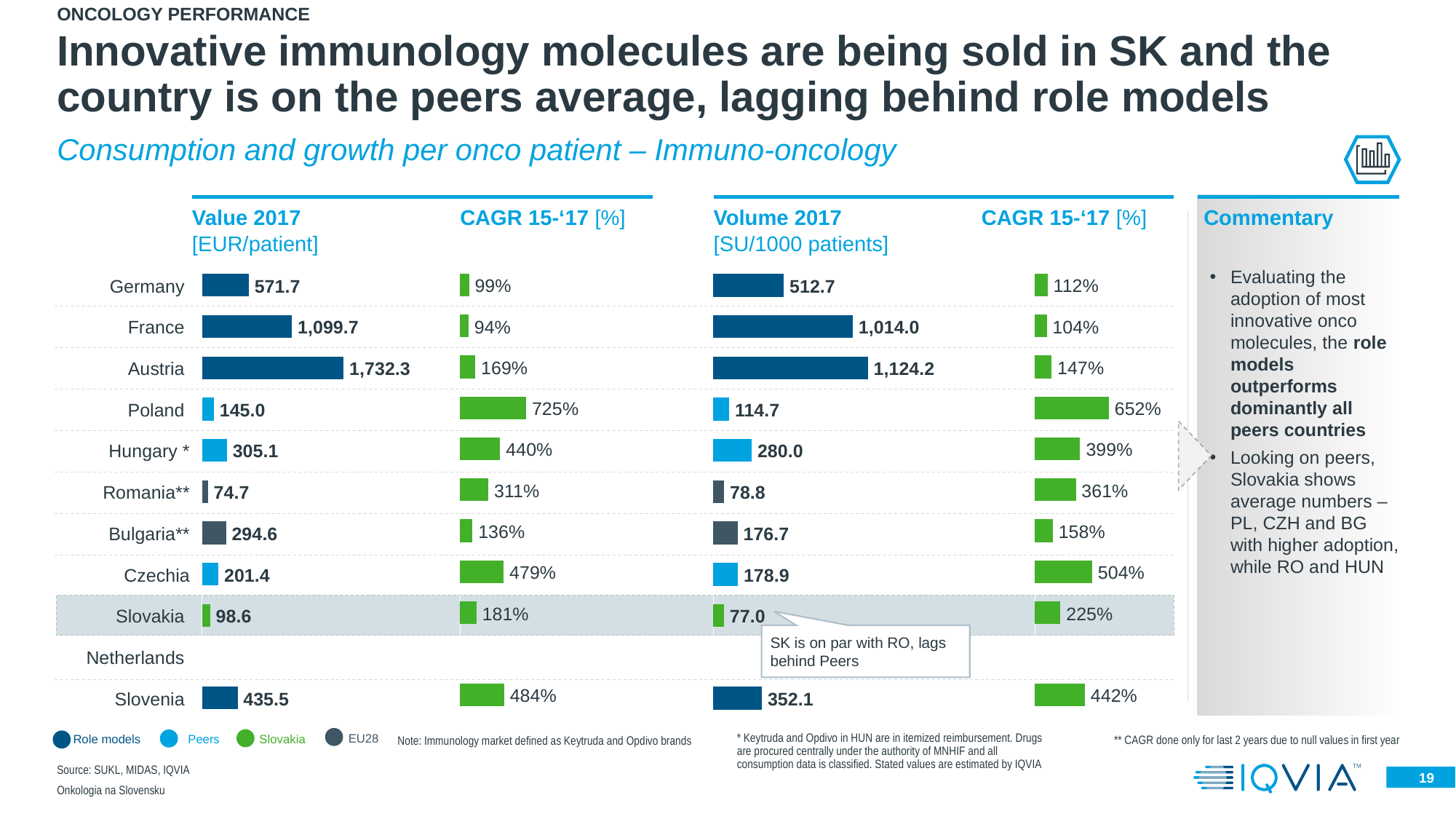
In the Value 2017 [EUR/patient] chart, what is the value for Austria? 1,732.3 In the Value 2017 [EUR/patient] chart, which country has the highest value? Austria In the CAGR 15-'17 [%] chart next to Value 2017, which country has the lowest value? France In the Value 2017 [EUR/patient] chart, what is the difference between France and Germany? 528.0 How many countries are listed as rows on the slide? 11 In the Volume 2017 [SU/1000 patients] chart, what is the value for Slovakia? 77.0 In the CAGR 15-'17 [%] chart next to Volume 2017, what is the value for Czechia? 504% How many groups does the legend at the bottom of the slide list? 4 In the Volume 2017 [SU/1000 patients] chart, which is larger, Hungary or Bulgaria? Hungary In the CAGR 15-'17 [%] chart next to Value 2017, what is the value for Poland? 725% In the Volume 2017 [SU/1000 patients] chart, which country has the lowest value? Slovakia In the CAGR 15-'17 [%] chart next to Volume 2017, what is the difference between Poland and Slovakia? 427%